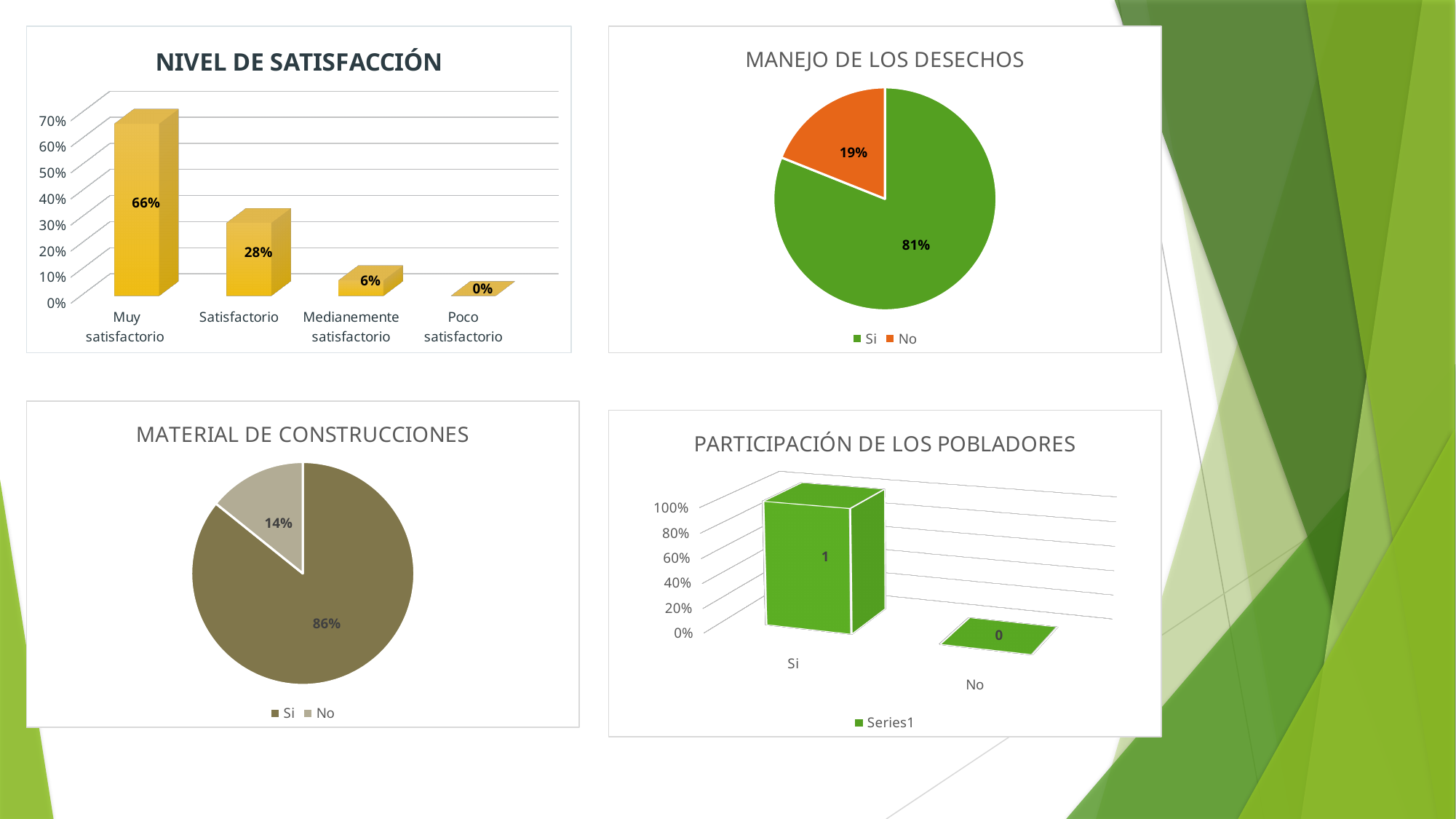
In the NIVEL DE SATISFACCIÓN chart, what is the difference between Muy satisfactorio and Satisfactorio? 38% In the NIVEL DE SATISFACCIÓN chart, how many categories are shown on the x axis? 4 In the MATERIAL DE CONSTRUCCIONES chart, what is the value for Si? 86% In the NIVEL DE SATISFACCIÓN chart, what is the value for Muy satisfactorio? 66% What kind of chart is MANEJO DE LOS DESECHOS? pie chart In the PARTICIPACIÓN DE LOS POBLADORES chart, what is the value for No? 0 In the NIVEL DE SATISFACCIÓN chart, which category has the lowest value? Poco satisfactorio In the MANEJO DE LOS DESECHOS chart, what share of the pie is No? 19% In the MATERIAL DE CONSTRUCCIONES chart, which slice is larger, Si or No? Si In the NIVEL DE SATISFACCIÓN chart, what is the value for Satisfactorio? 28% In the NIVEL DE SATISFACCIÓN chart, do the values rise or fall from left to right along the x axis? fall In the PARTICIPACIÓN DE LOS POBLADORES chart, how many series does the legend list? 1